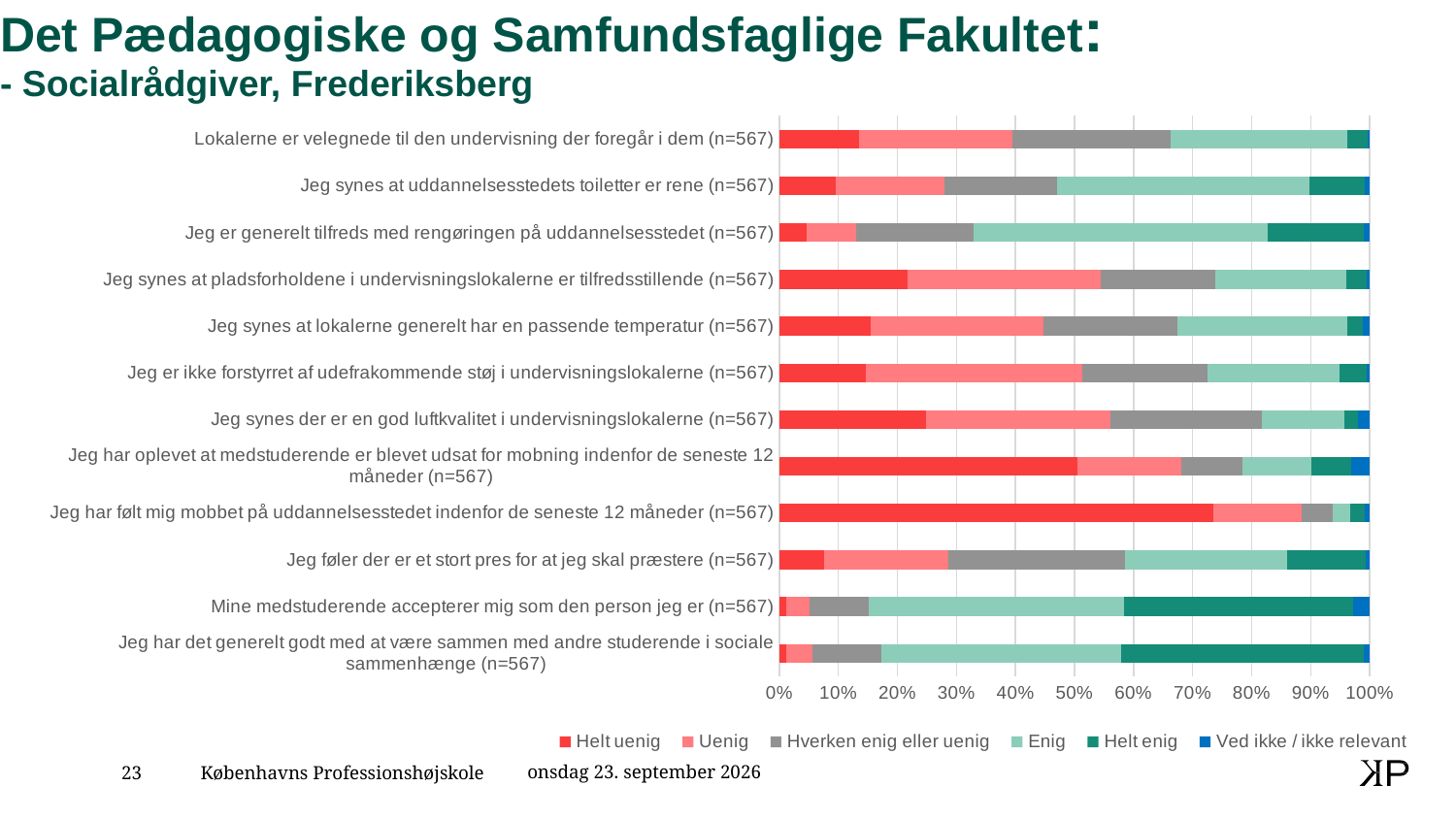
Which has the larger 'Helt enig' share: 'Mine medstuderende accepterer mig som den person jeg er' or 'Lokalerne er velegnede til den undervisning der foregår i dem'? Mine medstuderende accepterer mig som den person jeg er What kind of chart is shown on the slide? Stacked bar chart Is the 'Helt enig' share for 'Mine medstuderende accepterer mig som den person jeg er' greater or less than 30%? greater Is the 'Helt uenig' share for 'Jeg føler der er et stort pres for at jeg skal præstere' greater or less than 10%? less How many series does the legend list? 6 Is the 'Helt uenig' share for 'Jeg synes der er en god luftkvalitet i undervisningslokalerne' greater or less than 20%? greater Which statement has the largest 'Helt uenig' share? Jeg har følt mig mobbet på uddannelsesstedet indenfor de seneste 12 måneder (n=567) What is the sample size (n) shown for each statement in the chart? 567 Which has the larger 'Helt uenig' share: 'Jeg har følt mig mobbet på uddannelsesstedet indenfor de seneste 12 måneder' or 'Jeg føler der er et stort pres for at jeg skal præstere'? Jeg har følt mig mobbet på uddannelsesstedet indenfor de seneste 12 måneder What is the first series listed in the legend? Helt uenig How many statements (categories) are plotted in the chart? 12